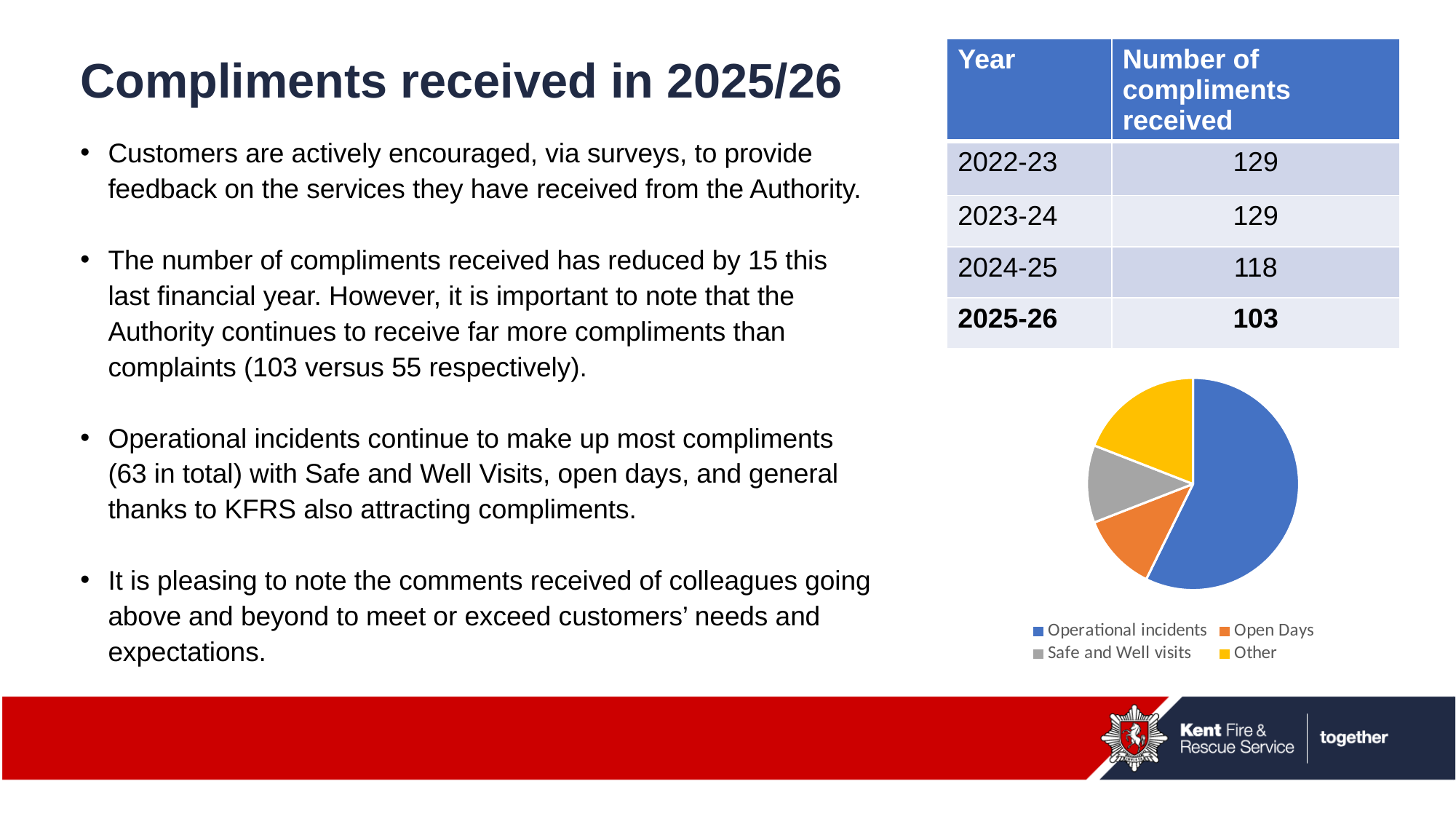
In the pie chart, which slice is larger: Operational incidents or Safe and Well visits? Operational incidents How many entries does the pie chart's legend list? 4 Which category has the largest slice in the pie chart? Operational incidents How many slices does the pie chart have? 4 What kind of chart is shown on the slide? pie chart What colour is the Operational incidents slice in the pie chart? blue Which legend entry in the pie chart is shown in yellow? Other Does the Operational incidents slice make up more or less than half of the pie chart? more than half In the pie chart, which slice is larger: Other or Open Days? Other In the pie chart, which slice is larger: Operational incidents or Other? Operational incidents